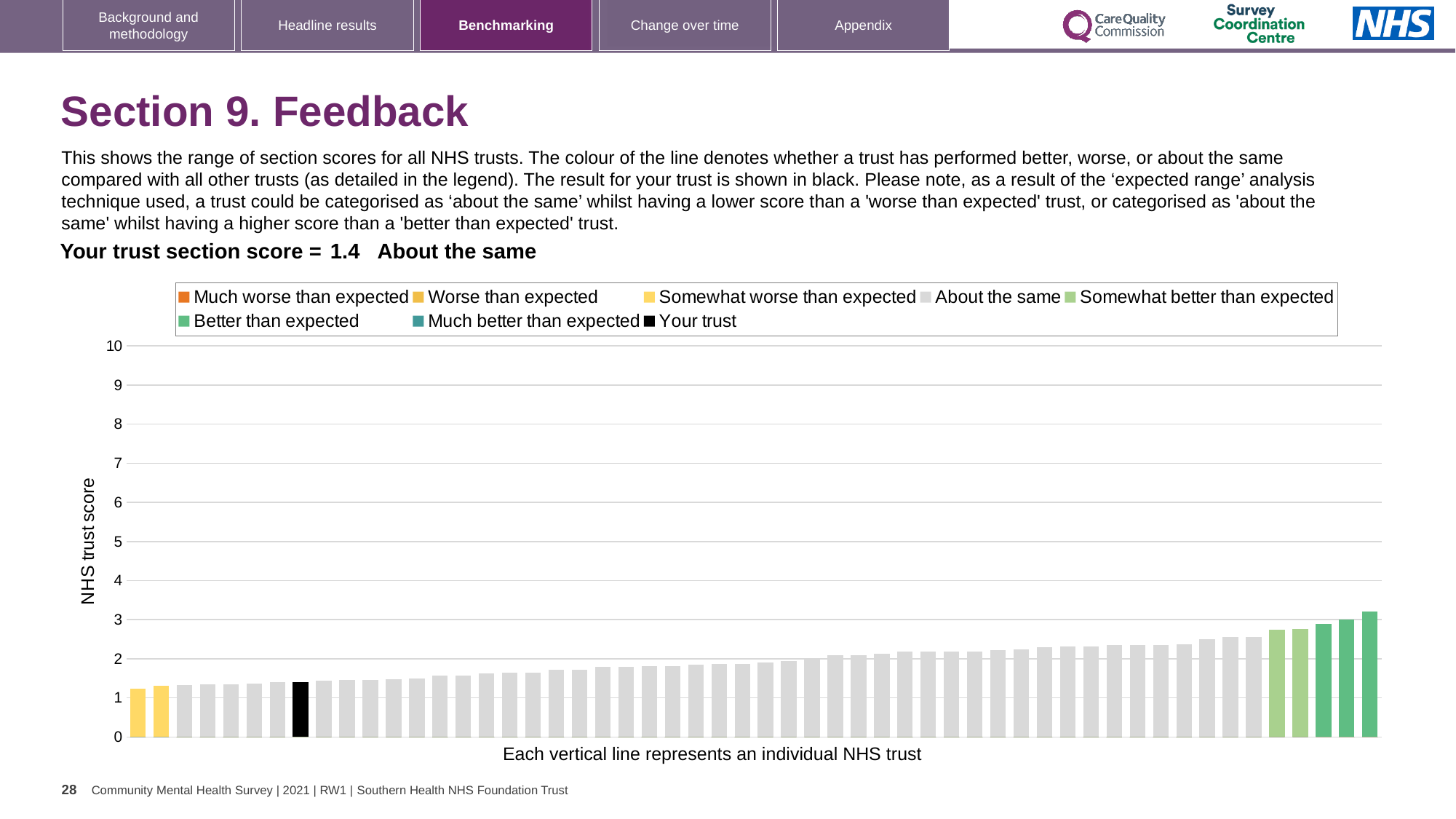
Which legend category does the shortest bar belong to? Somewhat worse than expected How many entries does the chart legend list? 8 What is the section score for your trust? 1.4 Which legend category does the tallest bar belong to? Better than expected What is the label on the vertical axis? NHS trust score Is the bar for your trust higher or lower than the rightmost bar? lower Do the bar values rise or fall from left to right along the x axis? rise Which category is your trust placed in according to the slide? About the same Is the value for your trust greater or less than 2? less Is the value of the tallest bar greater or less than 3? greater Is the value of the tallest bar greater or less than 4? less What kind of chart is shown on the slide? bar chart